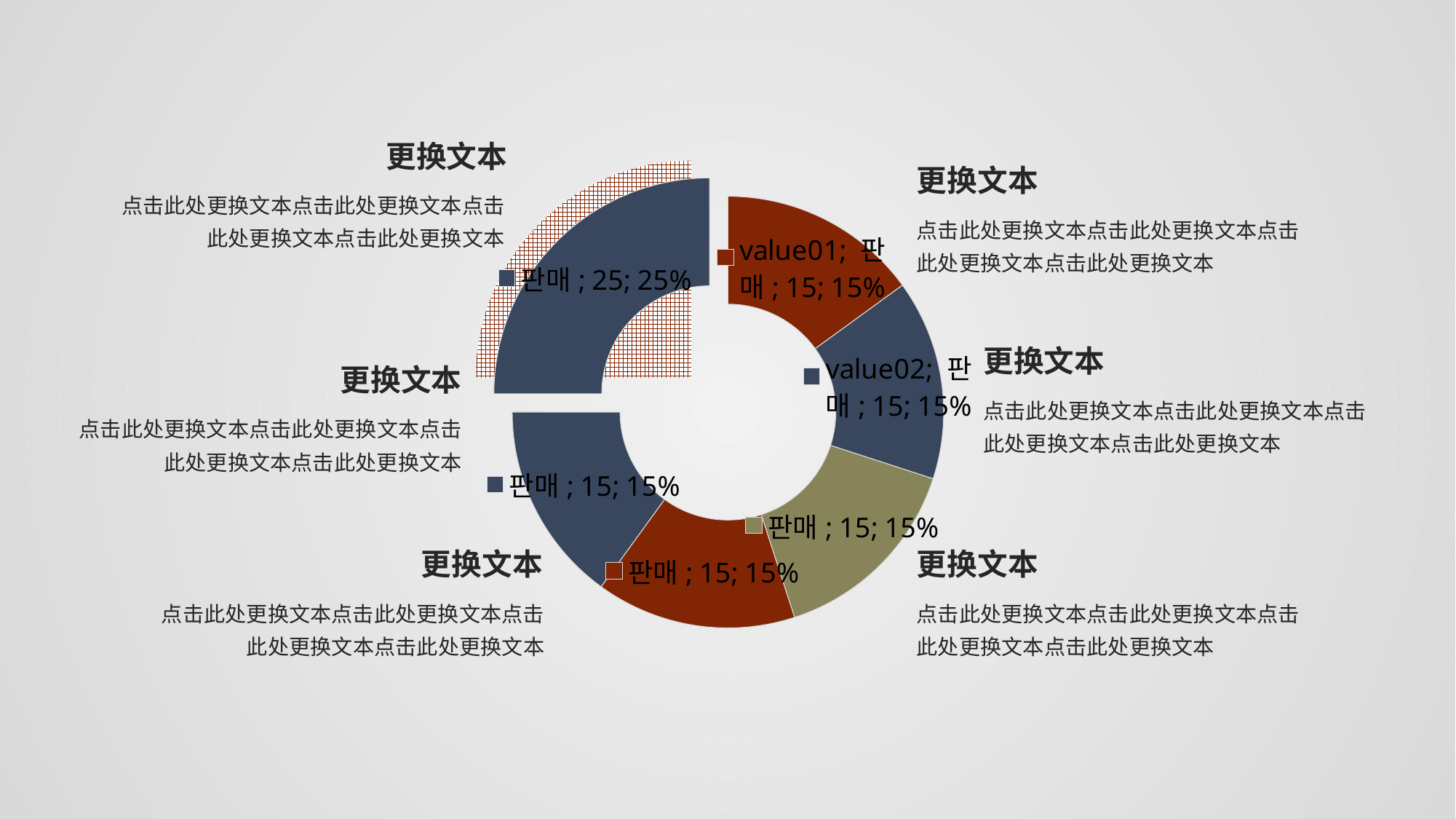
What is the difference between the largest slice's value (25) and the value for value01? 10 What series name appears in the data labels of the chart? 판매 What is the value shown for value02? 15 What is the largest share shown on any slice of the chart? 25% How many slices are labelled with 15%? 5 What is the value shown for value01? 15 What kind of chart is shown on the slide? Doughnut (pie) chart What share of the doughnut does value02 represent? 15% What colour is the slice for value01? Dark red What share of the doughnut does value01 represent? 15% What is the total of all the slice values shown on the chart? 100 How many slices does the doughnut chart have? 6